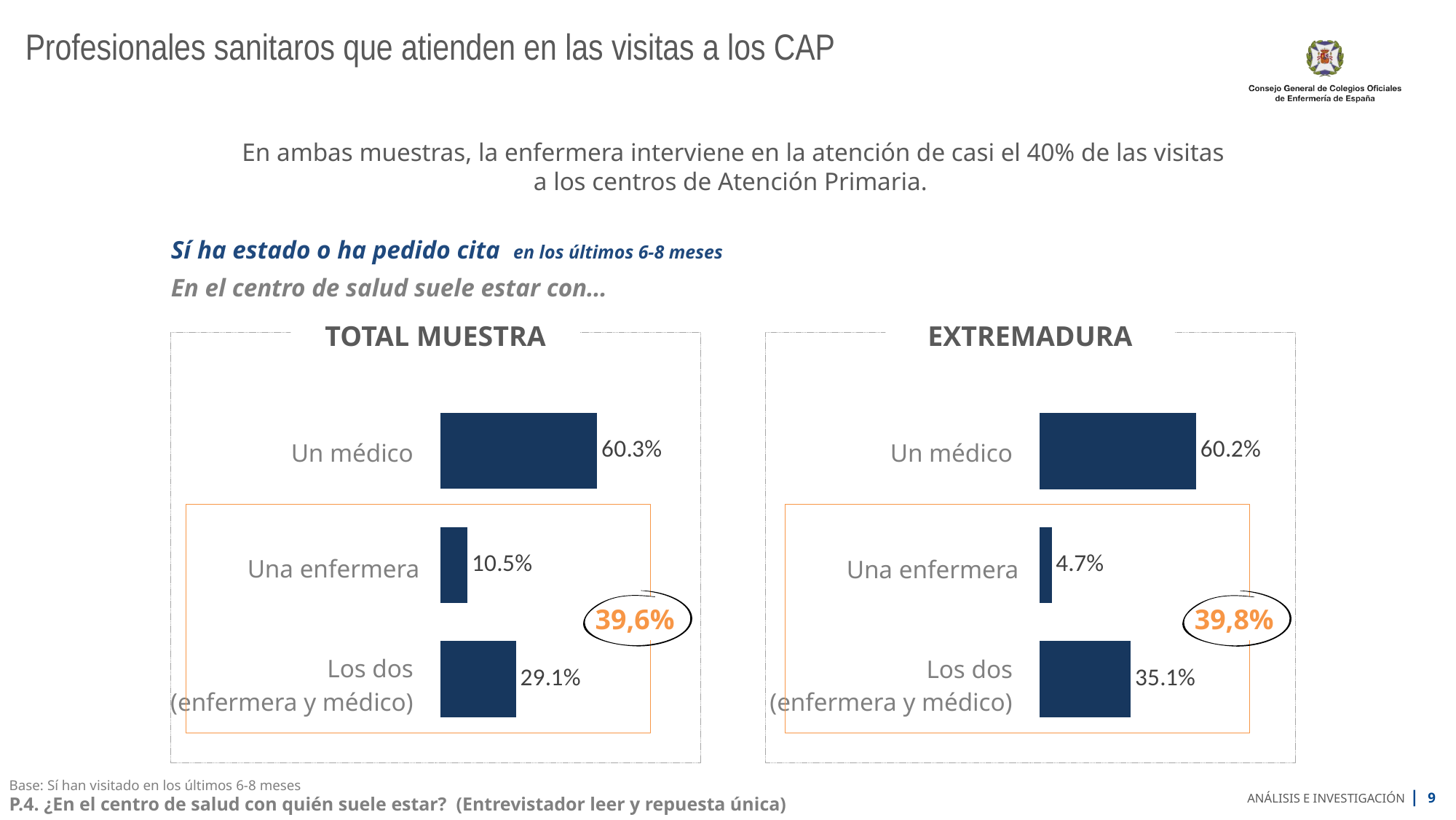
In the TOTAL MUESTRA chart, is the value for Los dos (enfermera y médico) larger than the value for Una enfermera? Yes In the EXTREMADURA chart, what is the value for Una enfermera? 4.7% What is the circled combined percentage shown in orange on the EXTREMADURA chart? 39,8% In the TOTAL MUESTRA chart, what is the difference between Un médico and Los dos (enfermera y médico)? 31.2% In the TOTAL MUESTRA chart, which category has the lowest value? Una enfermera In the EXTREMADURA chart, which category has the highest value? Un médico In the EXTREMADURA chart, what is the difference between Los dos (enfermera y médico) and Una enfermera? 30.4% What kind of chart is the TOTAL MUESTRA chart? Bar chart How many categories does the EXTREMADURA chart show? 3 Which chart has the larger value for Una enfermera, TOTAL MUESTRA or EXTREMADURA? TOTAL MUESTRA In the TOTAL MUESTRA chart, what is the value for Un médico? 60.3% In the EXTREMADURA chart, what is the value for Los dos (enfermera y médico)? 35.1%